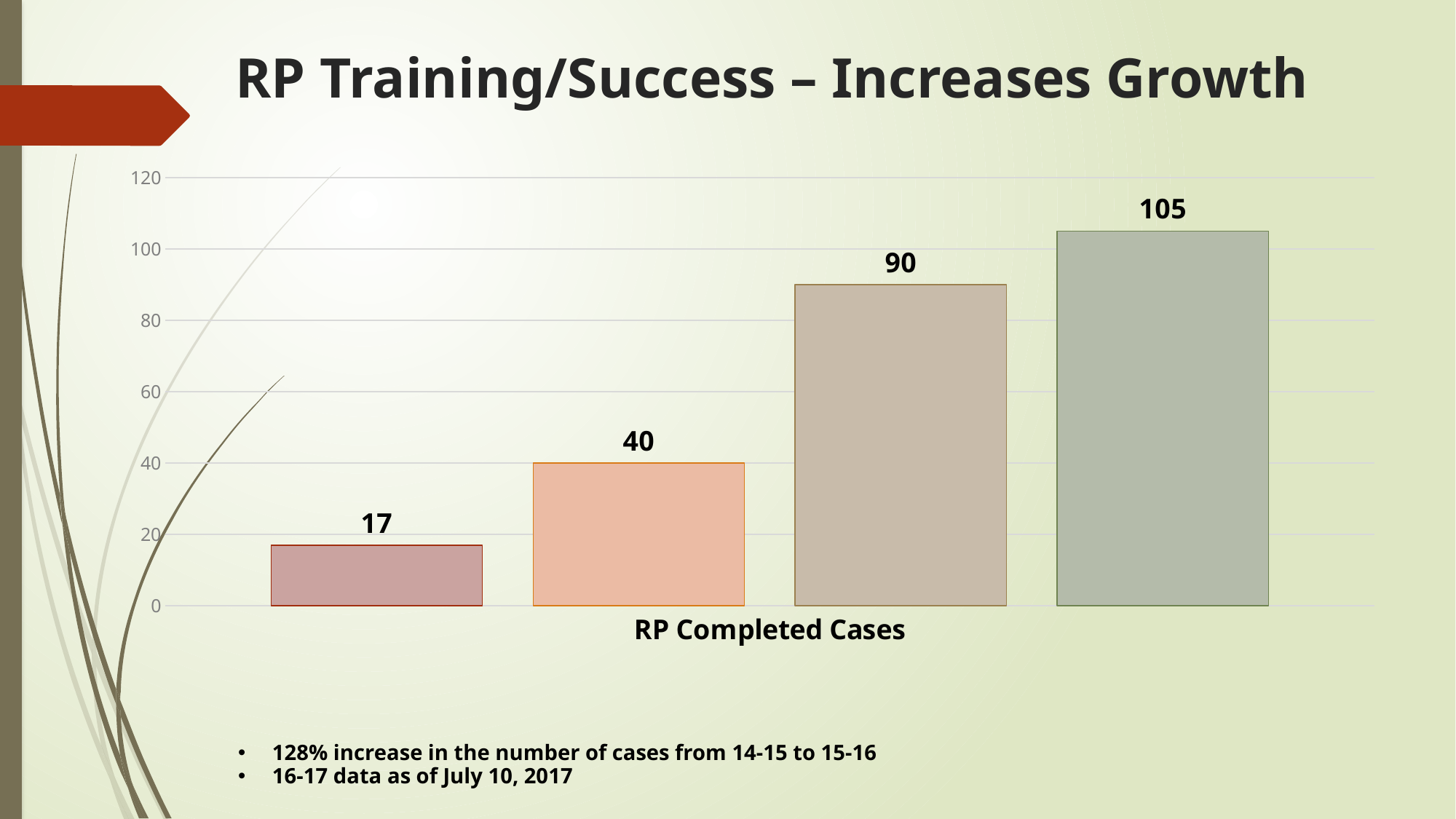
Do the values rise or fall from left to right across the chart? Rise Which bar has the highest value? The rightmost bar (105) Which is larger, the second bar or the third bar? The third bar (90) What is the difference between the rightmost bar and the leftmost bar? 88 What is the value of the second bar from the left? 40 How many bars are plotted in the chart? 4 What is the difference between the third bar and the second bar? 50 What kind of chart is shown on the slide? Bar chart What is the value of the rightmost bar in the chart? 105 What is the value of the leftmost bar in the chart? 17 What is the value of the third bar from the left? 90 Which bar has the lowest value? The leftmost bar (17)